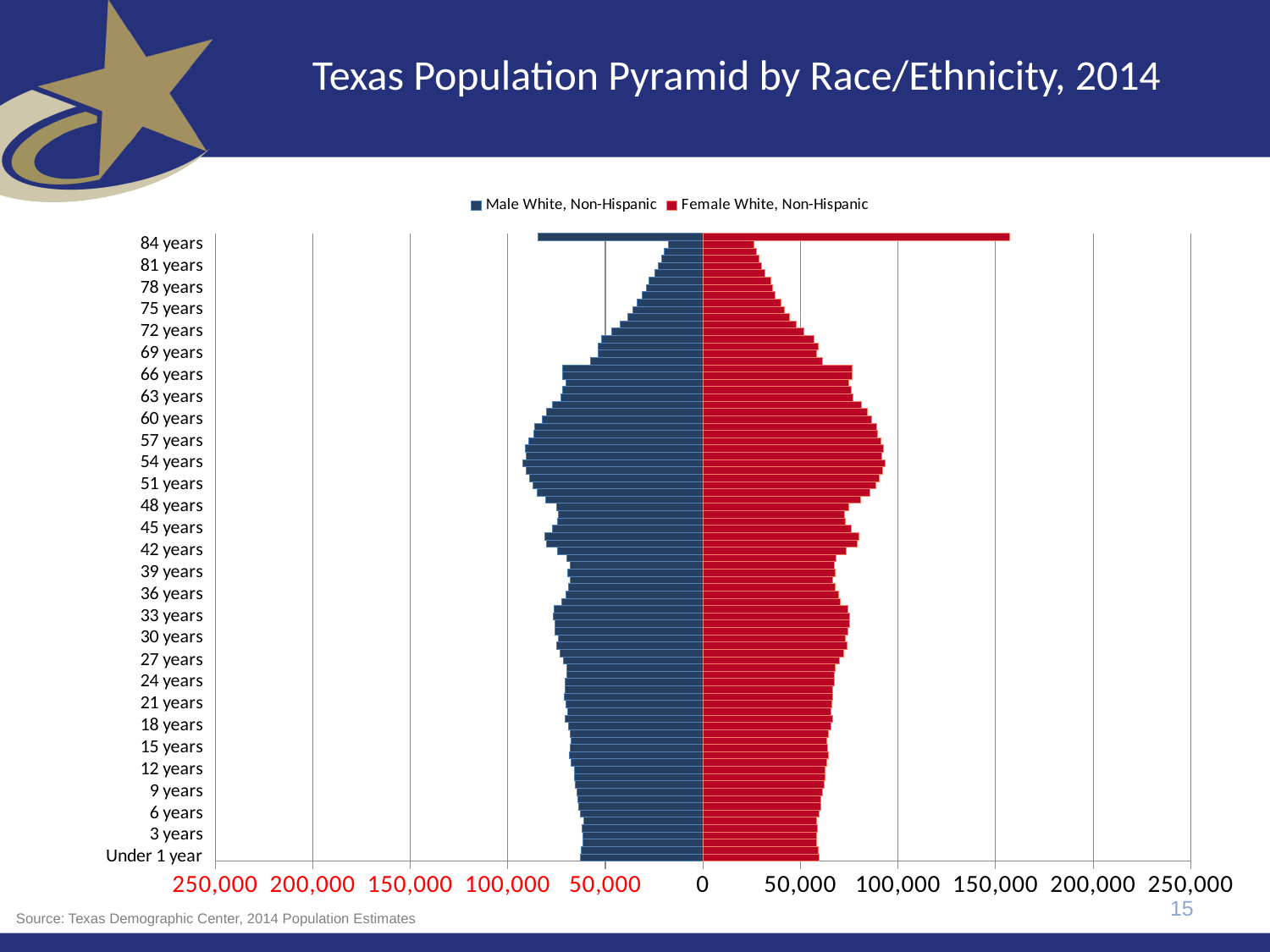
Is the value for Male White, Non-Hispanic at 54 years greater or less than 50,000? greater For Male White, Non-Hispanic, which is larger: the value at 54 years or the value at 75 years? 54 years Is the value for Female White, Non-Hispanic at Under 1 year greater or less than 100,000? less What type of chart is shown on the slide? Bar chart For Male White, Non-Hispanic, do the bars get longer or shorter as age increases from 54 years to 81 years? shorter How many series does the legend list? 2 Is the value for Female White, Non-Hispanic at 84 years greater or less than 100,000? less Which series is shown in red? Female White, Non-Hispanic At 84 years, which is larger: the Male White, Non-Hispanic value or the Female White, Non-Hispanic value? Female White, Non-Hispanic What is the title of the chart? Texas Population Pyramid by Race/Ethnicity, 2014